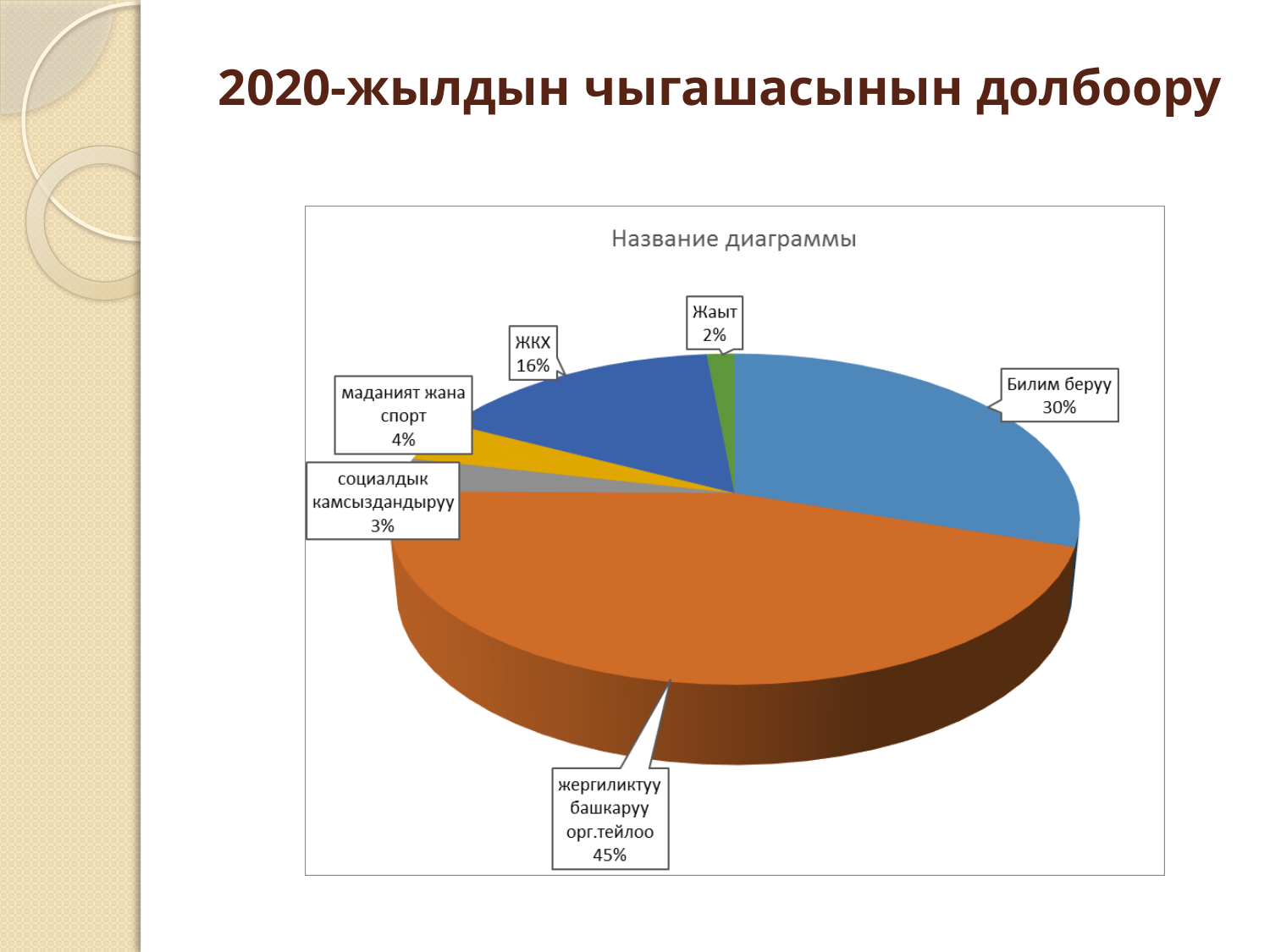
What kind of chart is shown on the slide? pie chart What is the difference between the shares of "жергиликтуу башкаруу орг.тейлоо" and "Билим беруу"? 15% How many slices does the pie chart have? 6 What is the value shown for "маданият жана спорт"? 4% Which category has the largest slice of the pie? жергиликтуу башкаруу орг.тейлоо What is the value shown for "социалдык камсыздандыруу"? 3% What is the value shown for "жергиликтуу башкаруу орг.тейлоо"? 45% What share of the pie does "Билим беруу" have? 30% What share of the pie does "ЖКХ" have? 16% Which is larger, the share for "ЖКХ" or the share for "маданият жана спорт"? ЖКХ Which category has the smallest slice of the pie? Жаыт What is the title shown inside the chart area? Название диаграммы